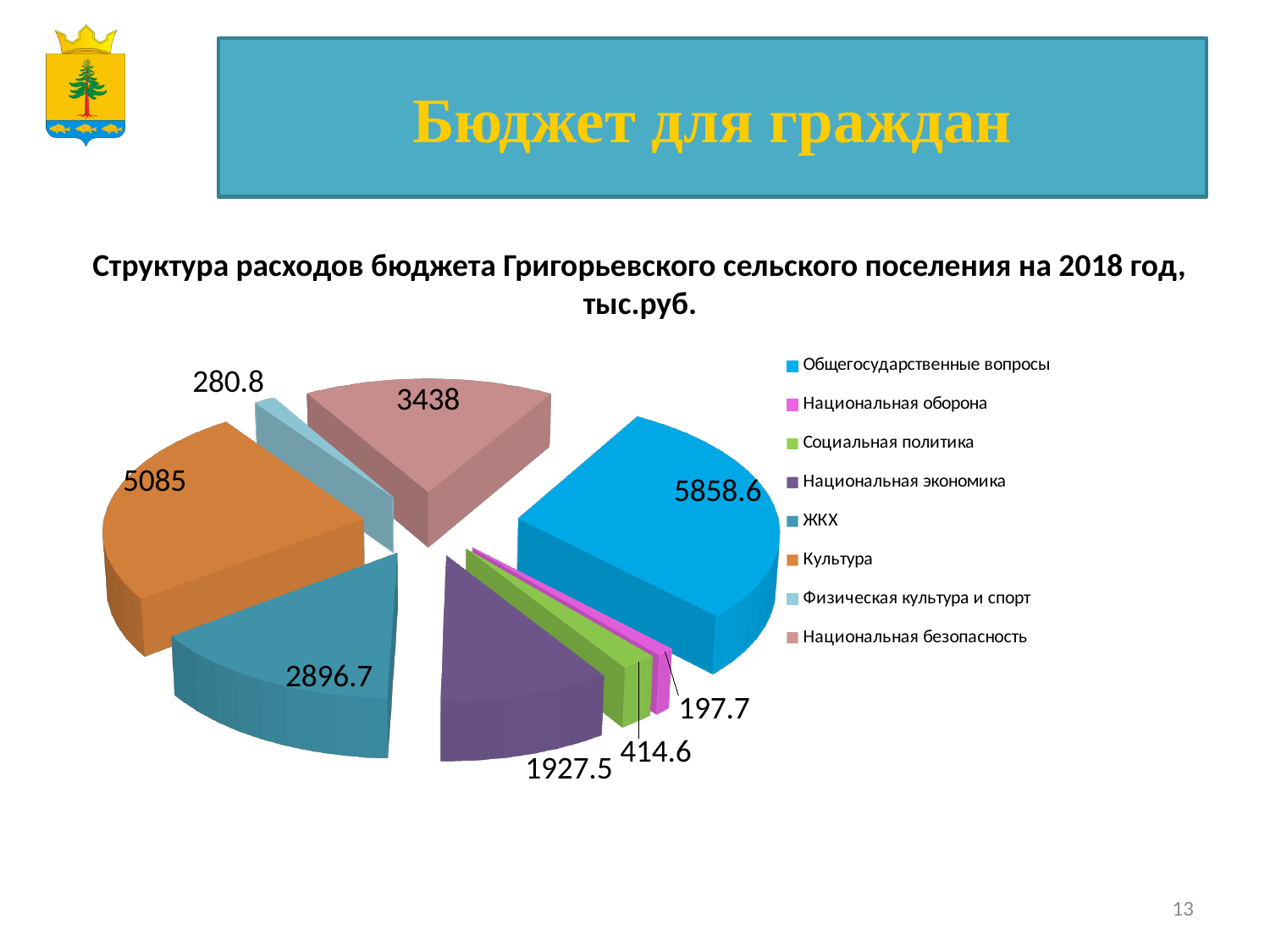
Which category has the smallest slice of the pie? Национальная оборона What is the value for Национальная оборона? 197.7 What is the value for Культура? 5085 What is the difference between the values for Общегосударственные вопросы and Культура? 773.6 How many categories does the legend list? 8 What is the title of the chart? Структура расходов бюджета Григорьевского сельского поселения на 2018 год, тыс.руб. What is the value for Общегосударственные вопросы? 5858.6 Which category has the largest slice of the pie? Общегосударственные вопросы Which is larger, the value for Национальная безопасность or the value for ЖКХ? Национальная безопасность What type of chart is shown on the slide? pie chart What is the value for Физическая культура и спорт? 280.8 What is the value for ЖКХ? 2896.7